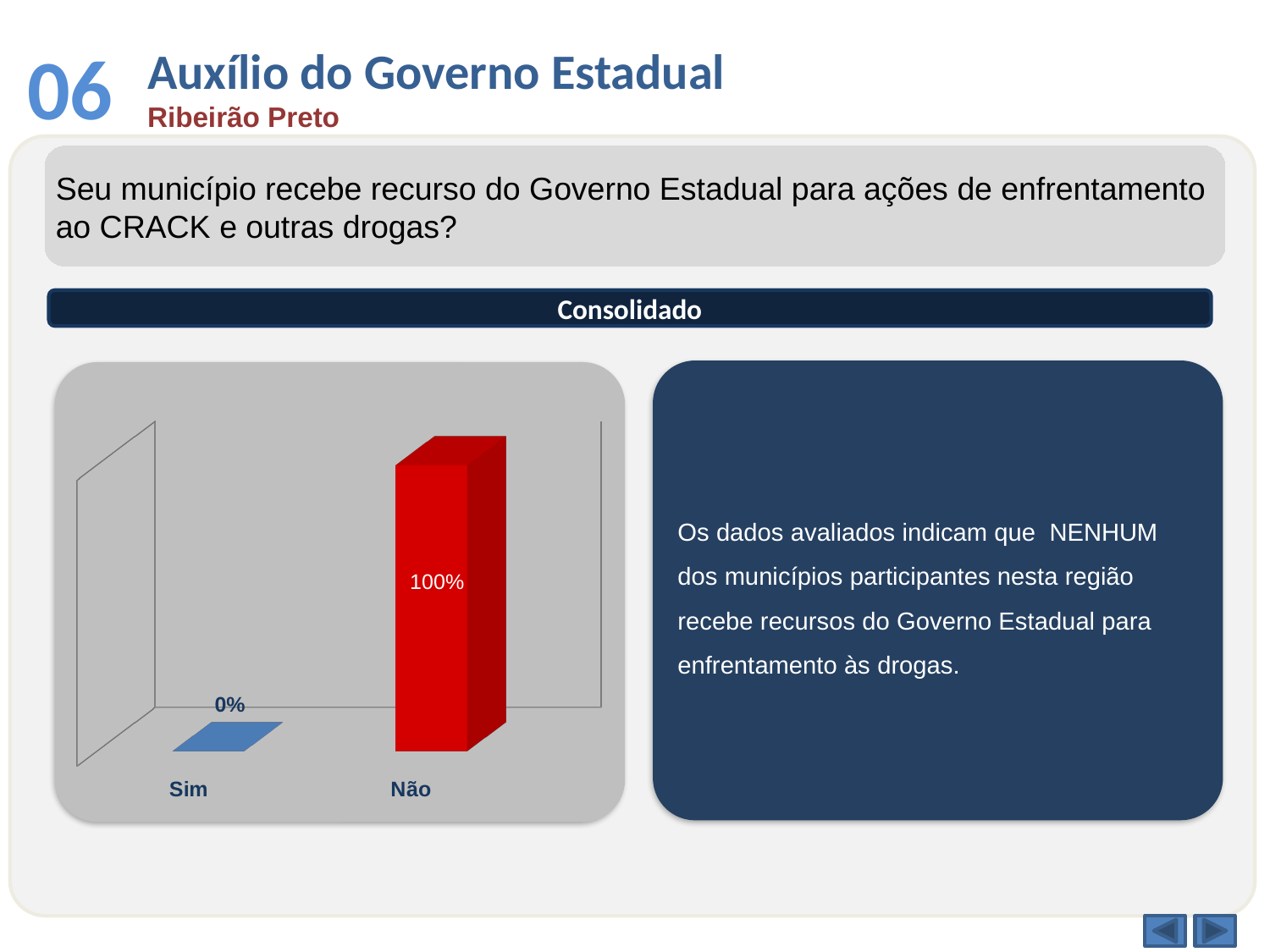
What colour is the bar for "Sim"? Blue Which is larger, the value for "Sim" or the value for "Não"? Não What is the value for "Sim" in the chart? 0% What kind of chart is shown on the slide? Bar chart Which category has the highest value in the chart? Não What colour is the bar for "Não"? Red How many categories are shown in the chart? 2 What is the value for "Não" in the chart? 100% What is the difference between the values for "Não" and "Sim"? 100% Which category has the lowest value in the chart? Sim What is the total of the values for "Sim" and "Não"? 100%